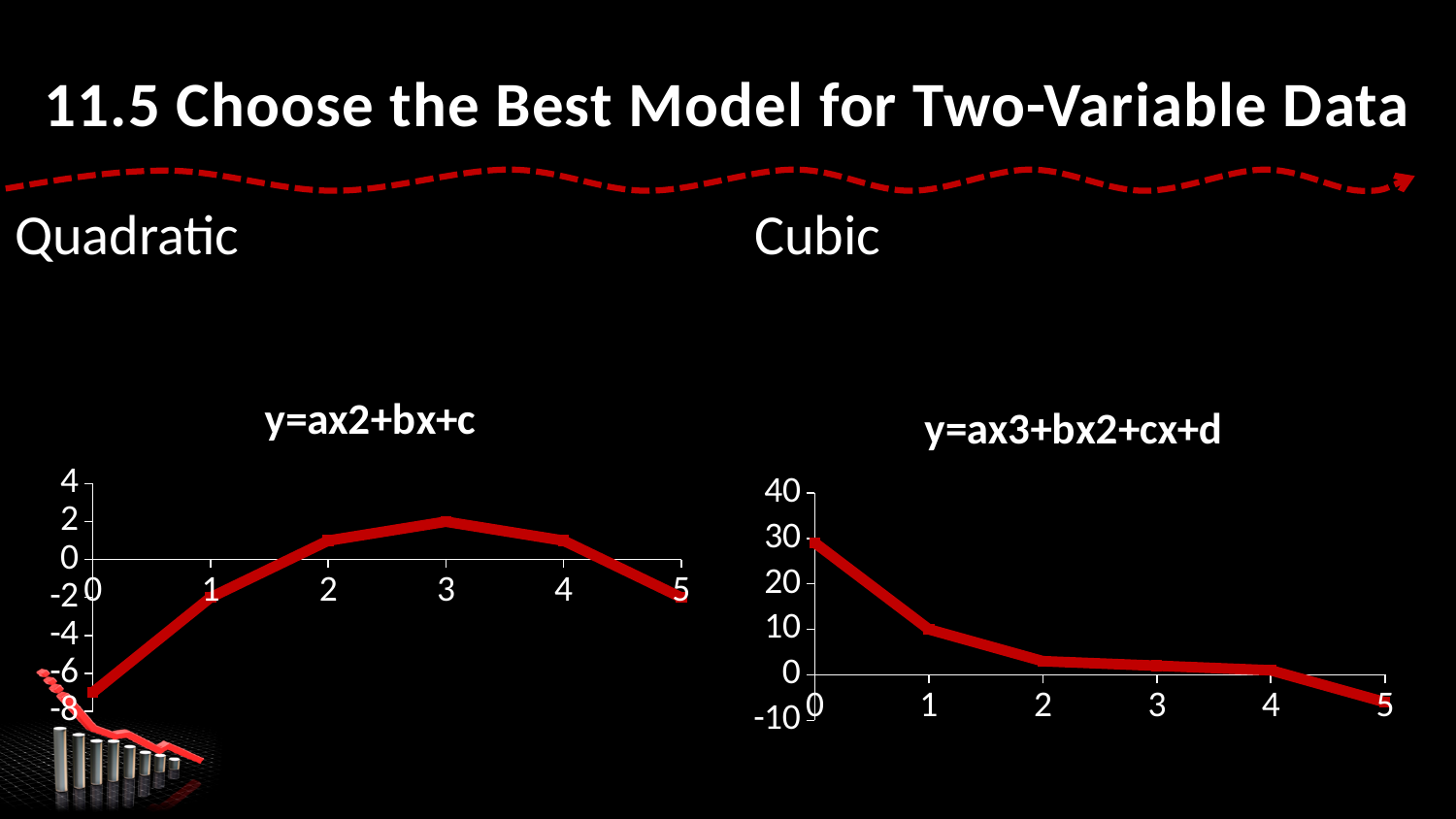
In the chart titled "y=ax2+bx+c", how many data points are plotted? 6 In the chart titled "y=ax3+bx2+cx+d", at which x value is the plotted value lowest? 5 In the chart titled "y=ax3+bx2+cx+d", how many data points are plotted? 6 In the chart titled "y=ax3+bx2+cx+d", at which x value is the plotted value highest? 0 In the chart titled "y=ax3+bx2+cx+d", which has the larger value, x=1 or x=4? x=1 In the chart titled "y=ax2+bx+c", at which x value is the plotted value lowest? 0 In the chart titled "y=ax3+bx2+cx+d", is the value at x=0 greater or less than 20? greater In the chart titled "y=ax2+bx+c", is the value at x=0 greater or less than -6? less What kind of chart is the chart titled "y=ax2+bx+c"? line chart In the chart titled "y=ax3+bx2+cx+d", do the values generally rise or fall as x increases from 0 to 5? fall In the chart titled "y=ax2+bx+c", at which x value is the plotted value highest? 3 What kind of chart is the chart titled "y=ax3+bx2+cx+d"? line chart